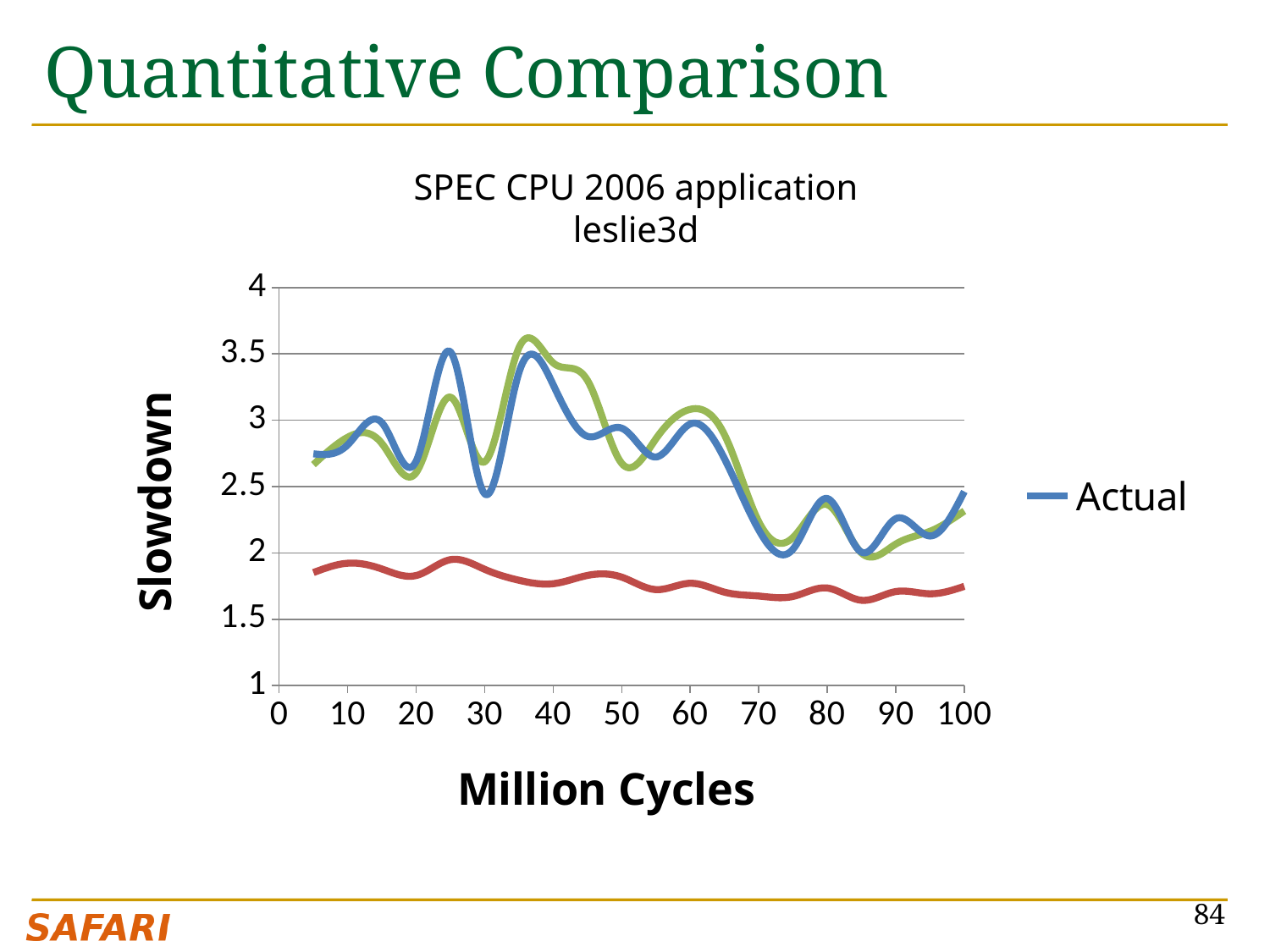
How many series does the legend list? 1 Is the value of the red line at 50 million cycles greater or less than 2? less Between 60 and 75 million cycles, does the Actual line rise or fall? fall What is the label of the x axis? Million Cycles Is the Actual value at 85 million cycles greater or less than 2.5? less At 50 million cycles, which is higher: the Actual line or the red line? Actual Is the Actual value at 75 million cycles greater or less than 2.5? less What kind of chart is shown on the slide? line chart How many lines are plotted on the chart? 3 What is the name of the series listed in the legend? Actual